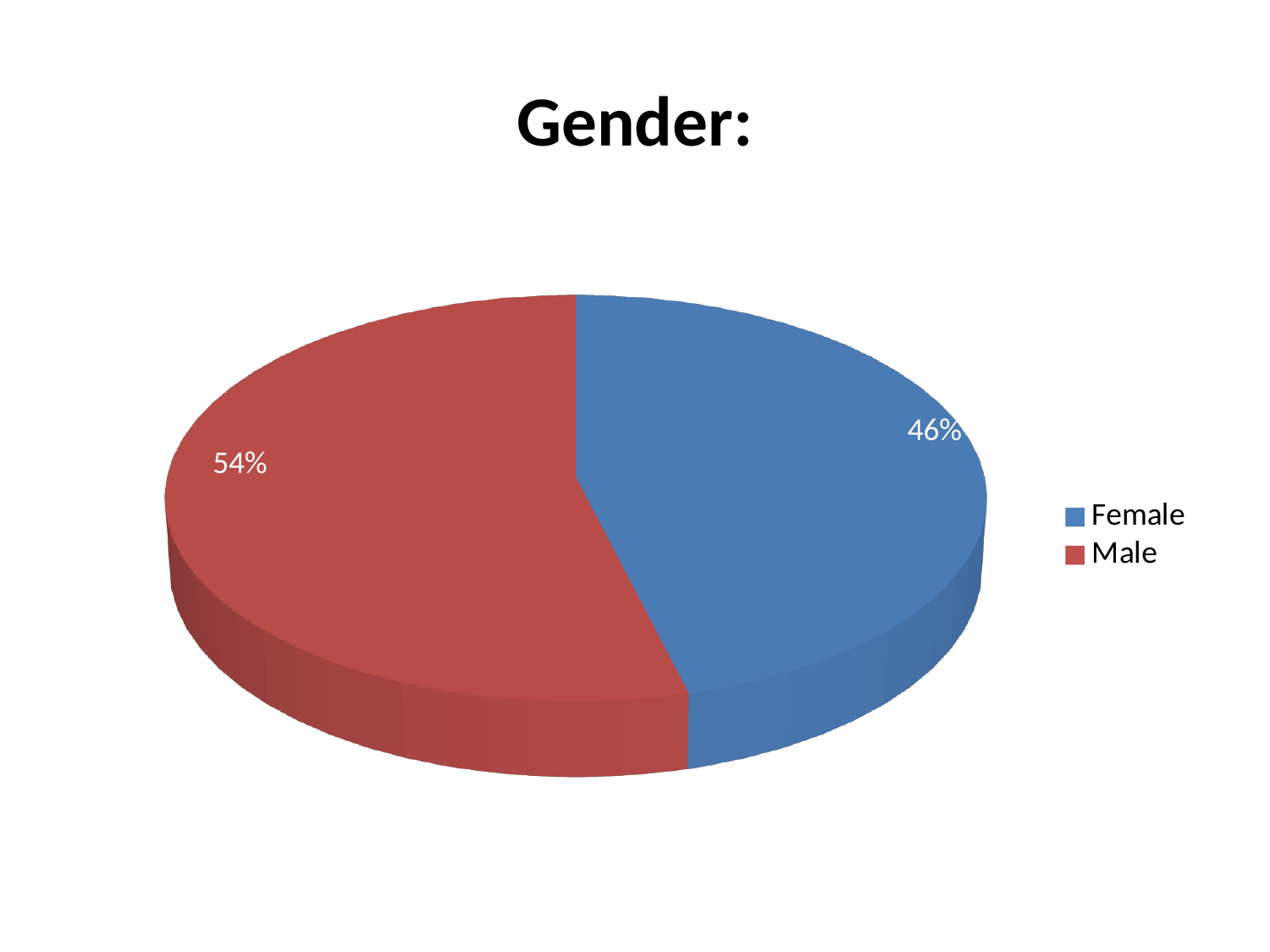
Which category has the smallest share of the pie? Female What is the difference in percentage points between the Male and Female slices? 8 What is the title of the chart? Gender: What percentage of the pie is Male? 54% Which slice is larger, Female or Male? Male How many slices does the pie chart have? 2 Is the share for Male greater or less than 50%? greater What colour is the Female slice? blue What percentage of the pie is Female? 46% What kind of chart is shown on the slide? pie chart Which category has the largest share of the pie? Male How many entries does the legend list? 2